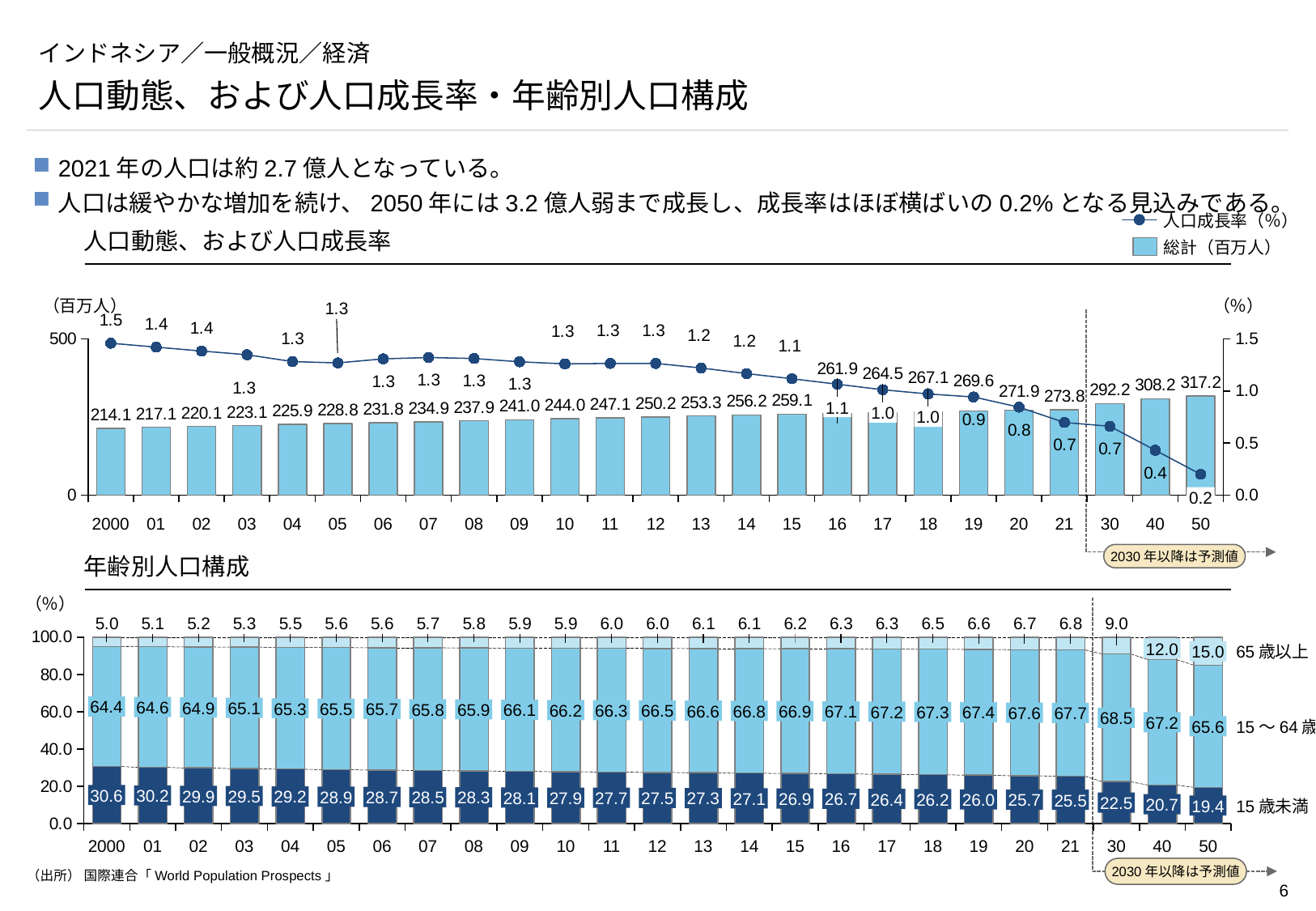
In the 人口動態、および人口成長率 chart, how many series does the legend list? 2 In the 人口動態、および人口成長率 chart, does the population growth rate line rise or fall from 2000 to 2050? fall In the 人口動態、および人口成長率 chart, what is the difference in total population (百万人) between 2050 and 2021? 43.4 In the 人口動態、および人口成長率 chart, what is the total population (百万人) for 2021? 273.8 In the 年齢別人口構成 chart, what is the share (%) of 65歳以上 in 2050? 15.0 In the 年齢別人口構成 chart, what is the share (%) of 15歳未満 in 2000? 30.6 In the 人口動態、および人口成長率 chart, what is the projected population growth rate (%) for 2050? 0.2 In the 人口動態、および人口成長率 chart, what is the population growth rate (%) for 2000? 1.5 In the 人口動態、および人口成長率 chart, which year has the highest total population (百万人)? 50 In the 年齢別人口構成 chart, what is the share (%) of 15～64歳 in 2030? 68.5 In the 年齢別人口構成 chart, which is larger in 2021: the share of 65歳以上 or the share of 15歳未満? 15歳未満 What kind of chart is the 年齢別人口構成 chart? stacked bar chart